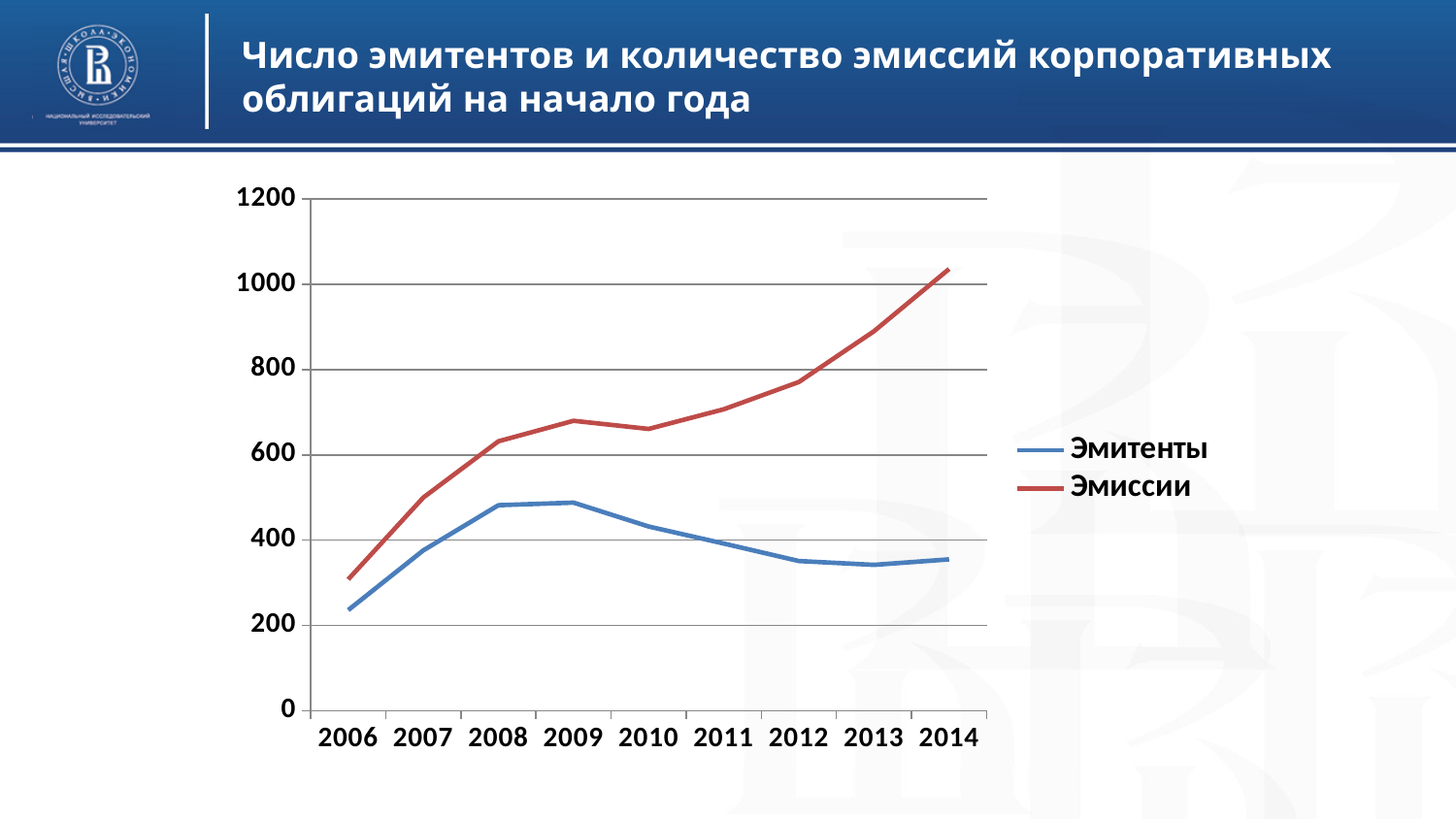
Which year has the lowest value for Эмитенты? 2006 Which year has the highest value for Эмиссии? 2014 Which year has the lowest value for Эмиссии? 2006 What colour is the line for Эмиссии? red Is the value for Эмиссии in 2009 greater or less than 600? greater What kind of chart is shown on the slide? line chart Does the Эмиссии line generally rise or fall from 2006 to 2014? rise How many series does the legend list? 2 In 2010, which series has the larger value, Эмитенты or Эмиссии? Эмиссии Is the value for Эмиссии in 2014 greater or less than 1000? greater Is the value for Эмитенты in 2012 greater or less than 400? less How many years are plotted along the x axis? 9